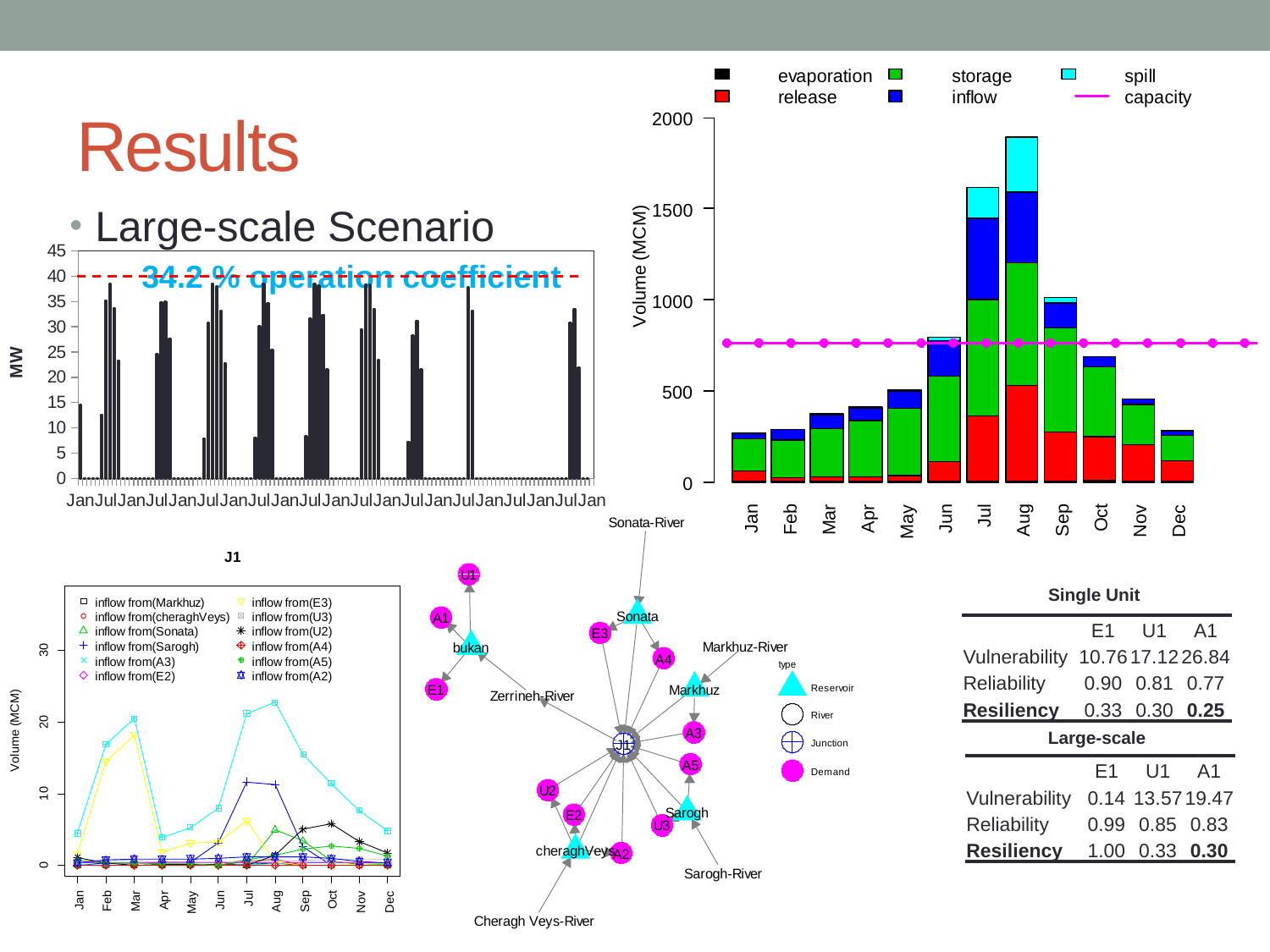
In the top-right Volume (MCM) chart, which series is drawn as a magenta line with dots rather than as bars? capacity In the top-right Volume (MCM) chart, do the stacked bar totals rise or fall from Aug to Dec? fall In the top-right Volume (MCM) chart, which month has the tallest stacked bar? Aug In the top-right Volume (MCM) chart, is the total stacked bar for Aug greater or less than 1500? greater How many series does the legend of the top-right Volume (MCM) chart list? 6 What kind of chart is the Volume (MCM) chart in the top right of the slide? bar chart How many series does the legend of the J1 chart in the bottom left list? 12 In the top-right Volume (MCM) chart, is the total stacked bar for Jun greater or less than 1000? less What kind of chart is the MW chart on the left of the slide? bar chart How many months are shown on the x axis of the top-right Volume (MCM) chart? 12 In the MW chart on the left, is the tallest bar greater or less than 40? less